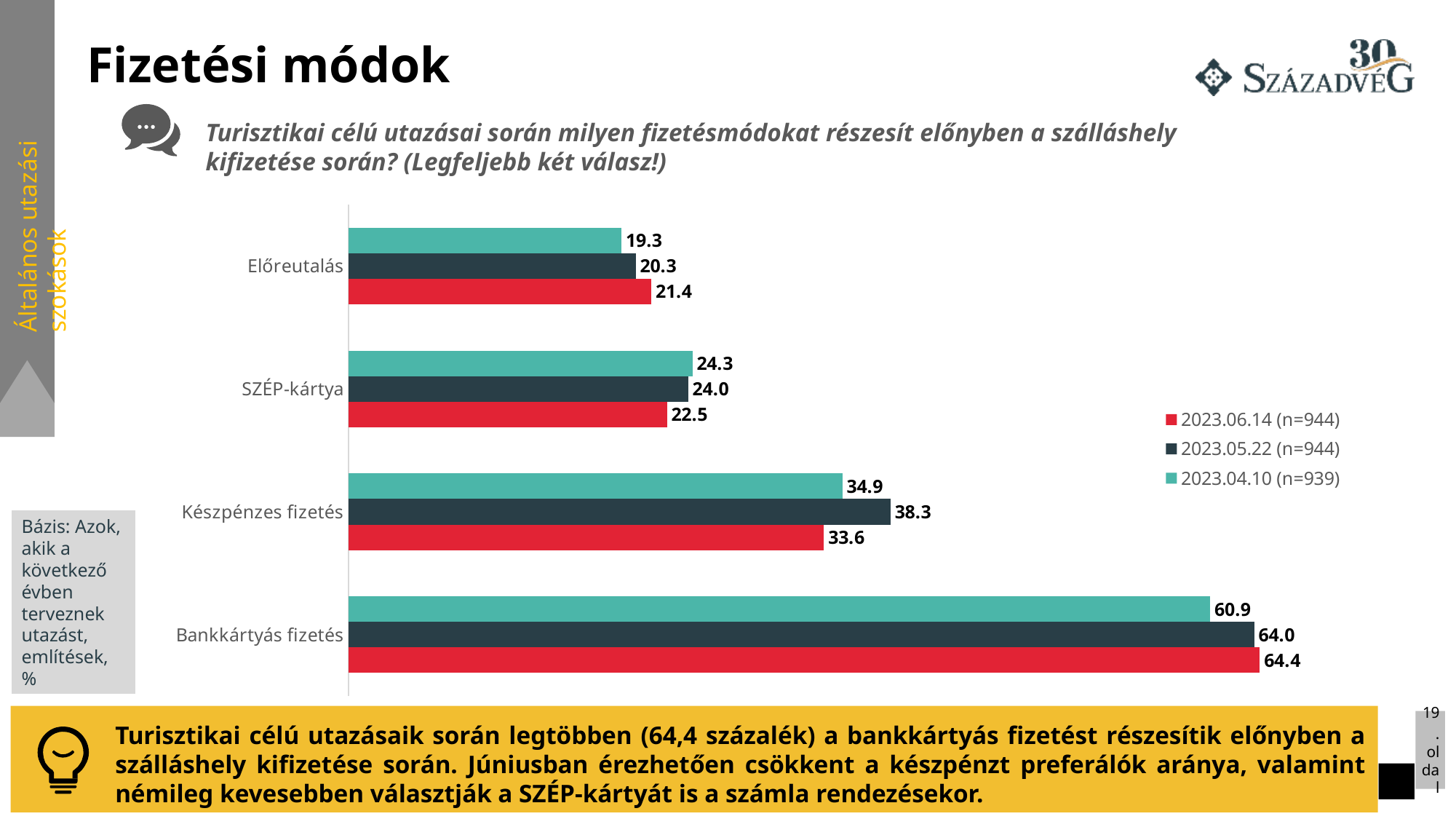
Which colour represents the 2023.04.10 (n=939) series? Teal Which is larger for SZÉP-kártya: the 2023.04.10 (n=939) value or the 2023.06.14 (n=944) value? 2023.04.10 (n=939) How many series does the legend list? 3 Which category has the highest value in the 2023.06.14 (n=944) series? Bankkártyás fizetés What is the difference between the 2023.05.22 (n=944) and 2023.06.14 (n=944) values for Készpénzes fizetés? 4.7 What kind of chart is shown on the slide? Bar chart What is the value for Készpénzes fizetés in the 2023.05.22 (n=944) series? 38.3 What is the value for SZÉP-kártya in the 2023.06.14 (n=944) series? 22.5 How many categories are shown on the chart? 4 What is the value for Bankkártyás fizetés in the 2023.06.14 (n=944) series? 64.4 What is the value for Előreutalás in the 2023.04.10 (n=939) series? 19.3 Which category has the lowest value in the 2023.04.10 (n=939) series? Előreutalás